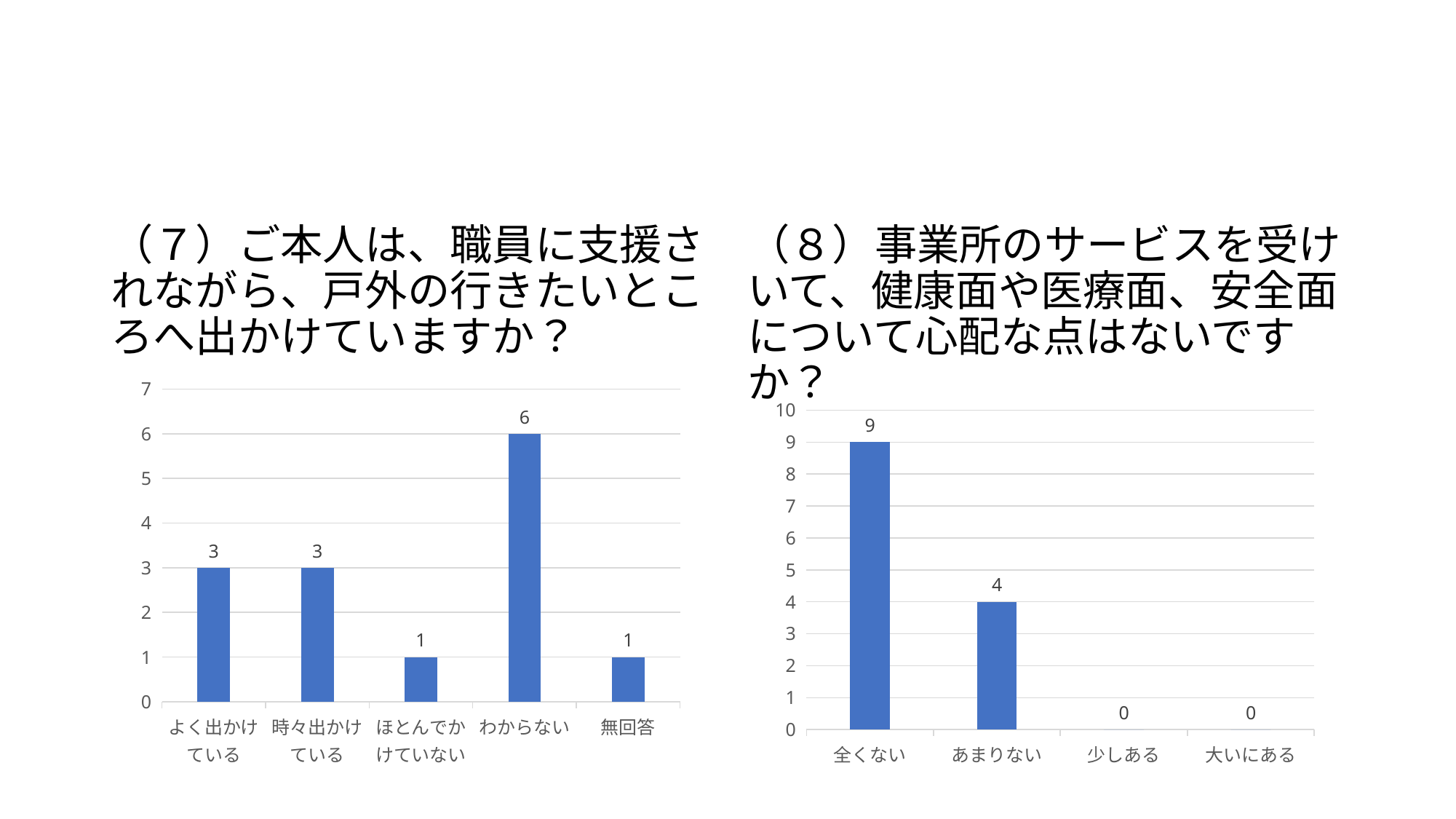
In the left chart (7), what is the value for わからない? 6 In the left chart (7), what is the total of all the plotted values? 14 In the right chart (8), what is the difference between the values for 全くない and あまりない? 5 In the left chart (7), what is the value for ほとんでかけていない? 1 In the right chart (8), what is the value for 全くない? 9 In the right chart (8), which category has the highest value? 全くない In the left chart (7), which category has the highest value? わからない In the right chart (8), what is the value for 少しある? 0 In the left chart (7), what is the difference between the values for わからない and よく出かけている? 3 In the left chart (7), how many categories are shown on the x axis? 5 What kind of chart is the right chart (8)? bar chart In the right chart (8), how many categories are shown on the x axis? 4